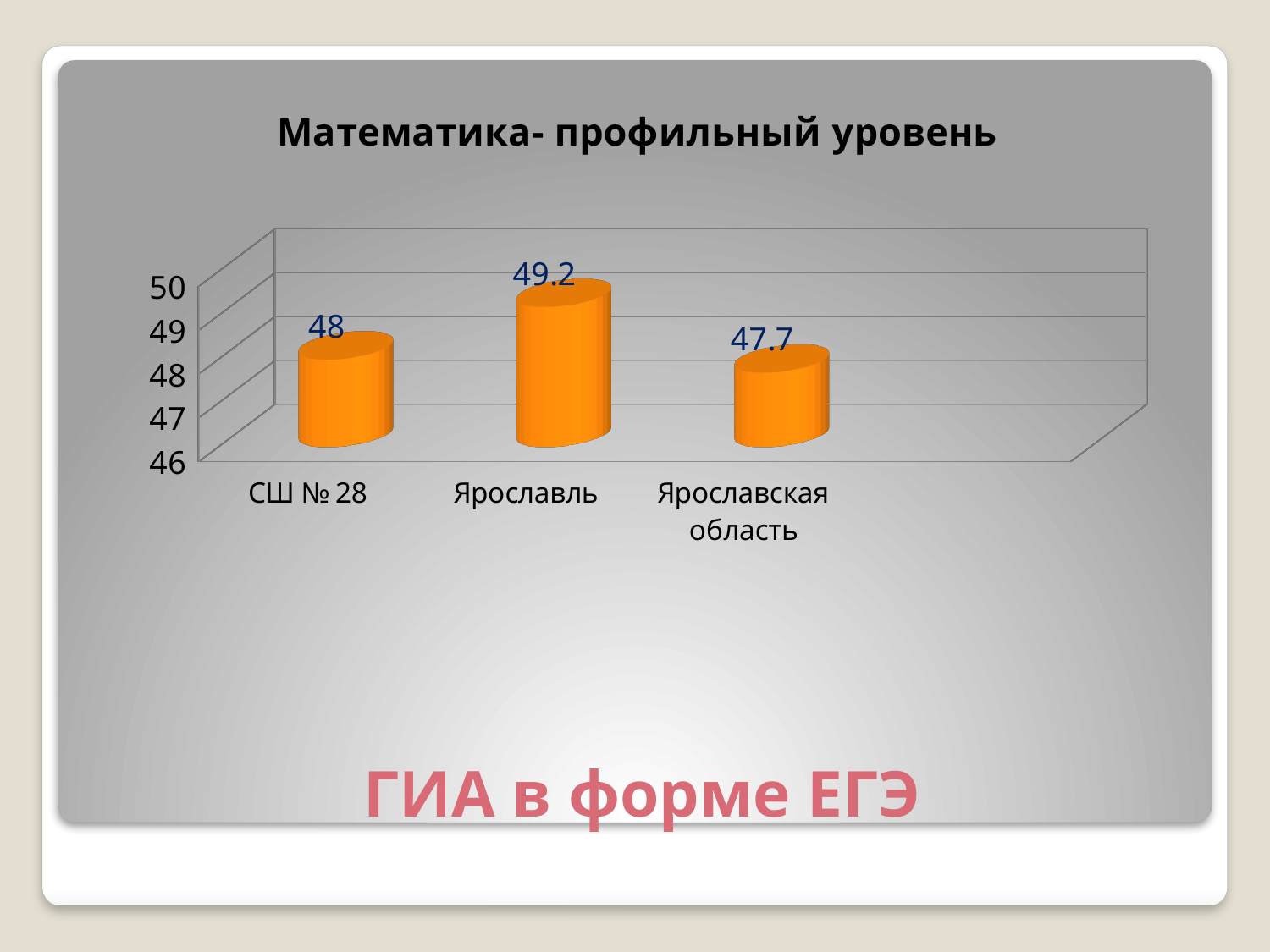
Is the value for Ярославль greater or less than 49? greater What is the difference between the values for СШ № 28 and Ярославская область? 0.3 Which is larger, the value for Ярославль or the value for Ярославская область? Ярославль What is the difference between the values for Ярославль and СШ № 28? 1.2 What is the title of the chart? Математика- профильный уровень Which category has the lowest value? Ярославская область Which category has the highest value? Ярославль What is the value for СШ № 28? 48 How many categories are shown in the chart? 3 What kind of chart is shown on the slide? bar chart What is the value for Ярославль? 49.2 What is the value for Ярославская область? 47.7